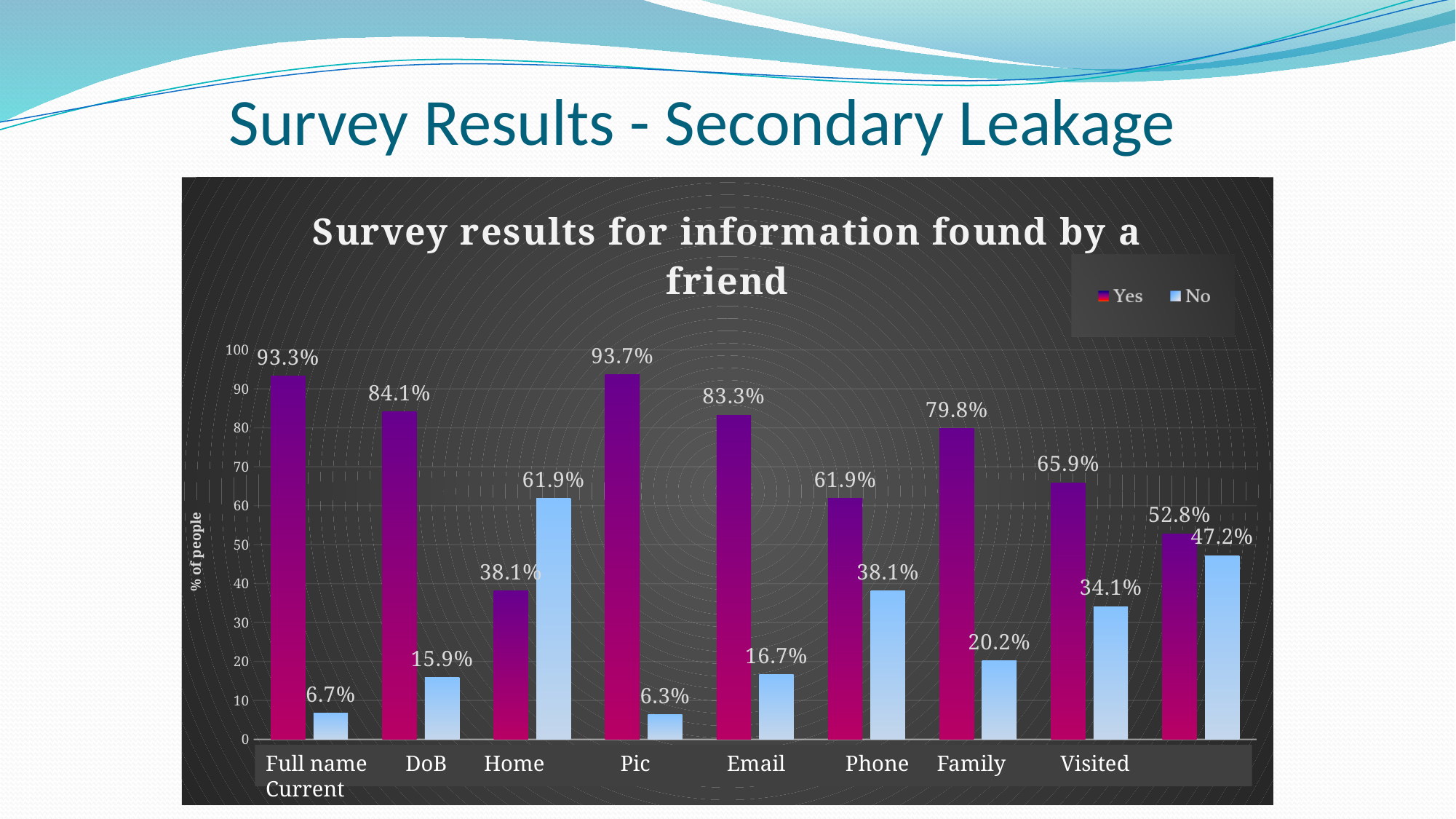
What is the No value for DoB? 15.9% What is the Yes value for Family? 79.8% Which is larger for Phone, the Yes value or the No value? Yes What is the difference between the Yes and No values for Email? 66.6% What is the No value for Visited? 34.1% Which category has the lowest Yes value? Home What is the title of the chart? Survey results for information found by a friend What is the Yes value for Pic? 93.7% What type of chart is shown on the slide? bar chart What is the label on the vertical axis? % of people Which category has the highest No value? Home How many series does the legend list? 2